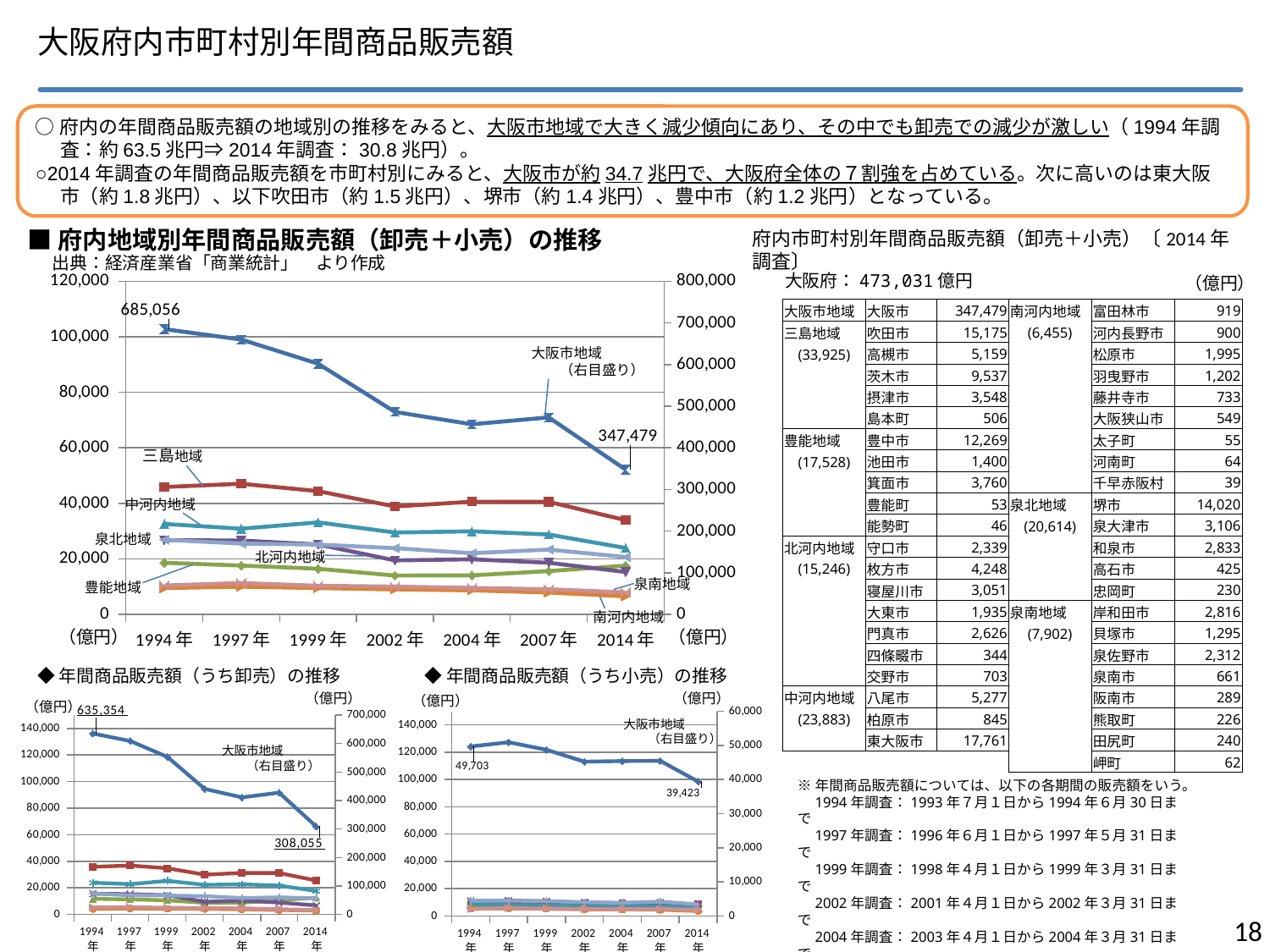
In the chart titled 年間商品販売額（うち小売）の推移, what is the difference between the 大阪市地域 values for 1994年 (49,703) and 2014年 (39,423)? 10,280 In the chart titled 府内地域別年間商品販売額（卸売＋小売）の推移, what is the value for 大阪市地域 in 1994年? 685,056 In the chart titled 年間商品販売額（うち卸売）の推移, what is the value for 大阪市地域 in 2014年? 308,055 What kind of chart is 府内地域別年間商品販売額（卸売＋小売）の推移? line chart In the chart titled 年間商品販売額（うち小売）の推移, what is the value for 大阪市地域 in 2014年? 39,423 In the chart titled 府内地域別年間商品販売額（卸売＋小売）の推移, is the value for 三島地域 in 2014年 greater or less than 40,000? less In the chart titled 府内地域別年間商品販売額（卸売＋小売）の推移, what is the value for 大阪市地域 in 2014年? 347,479 In the chart titled 府内地域別年間商品販売額（卸売＋小売）の推移, what is the difference between the 大阪市地域 values for 1994年 and 2014年? 337,577 In the chart titled 年間商品販売額（うち卸売）の推移, what is the value for 大阪市地域 in 1994年? 635,354 In the chart titled 府内地域別年間商品販売額（卸売＋小売）の推移, how many survey years are plotted on the x axis? 7 In the chart titled 府内地域別年間商品販売額（卸売＋小売）の推移, does the 大阪市地域 line rise or fall from 1994年 to 2014年? fall In the chart titled 府内地域別年間商品販売額（卸売＋小売）の推移, is the value for 三島地域 in 1994年 greater or less than 40,000? greater